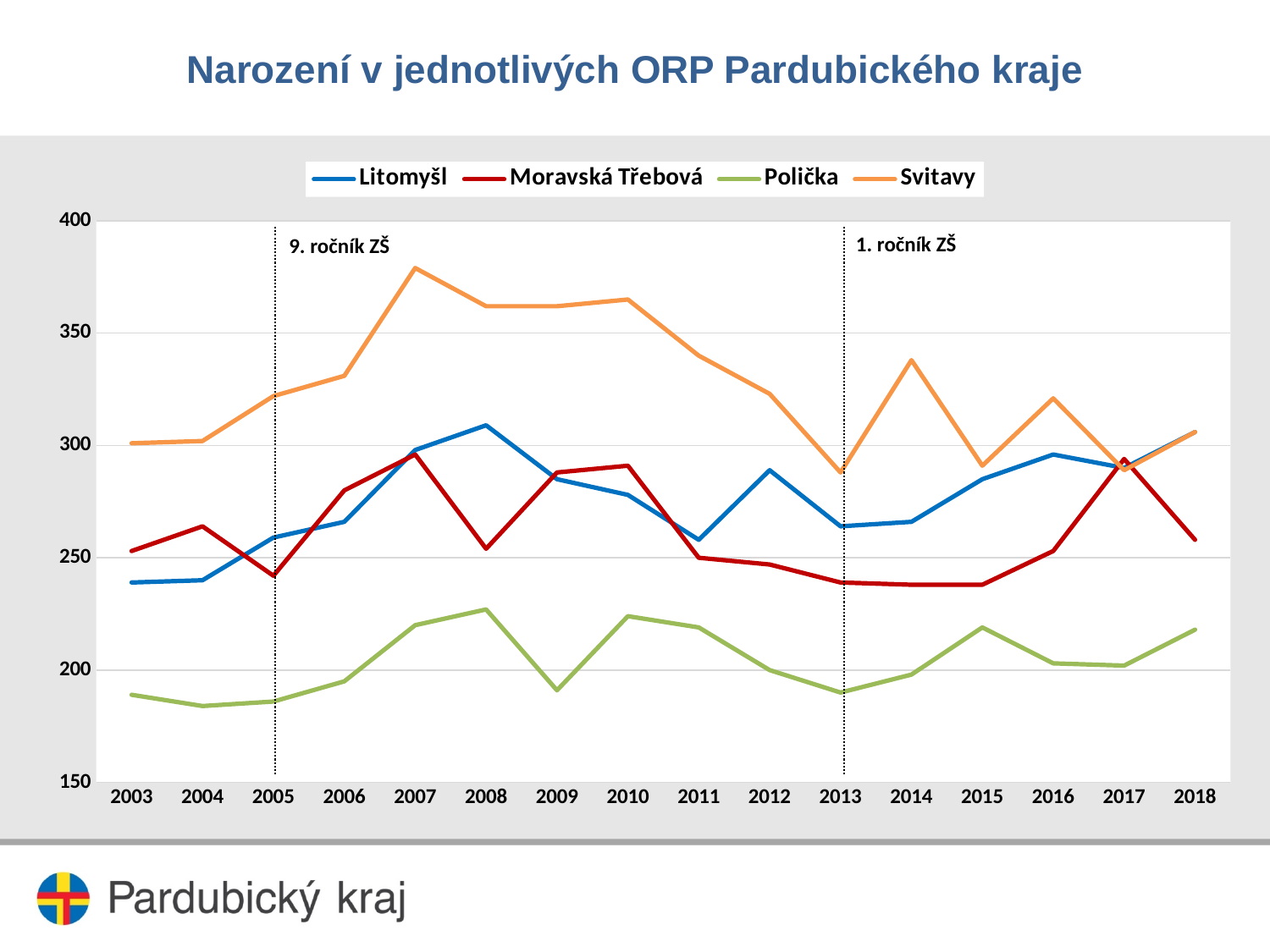
What kind of chart is shown on the slide? line chart In 2012, which is larger: the value for Litomyšl or for Moravská Třebová? Litomyšl Is the value for Svitavy in 2007 greater or less than 350? greater Is the value for Litomyšl in 2003 greater or less than 250? less How many series does the legend list? 4 How many years are shown on the x axis? 16 What is the title of the chart? Narození v jednotlivých ORP Pardubického kraje Which series has the highest value in 2007? Svitavy Is the value for Polička in 2009 greater or less than 200? less Does the Svitavy line rise or fall from 2007 to 2013? fall Which series has the lowest value in 2008? Polička